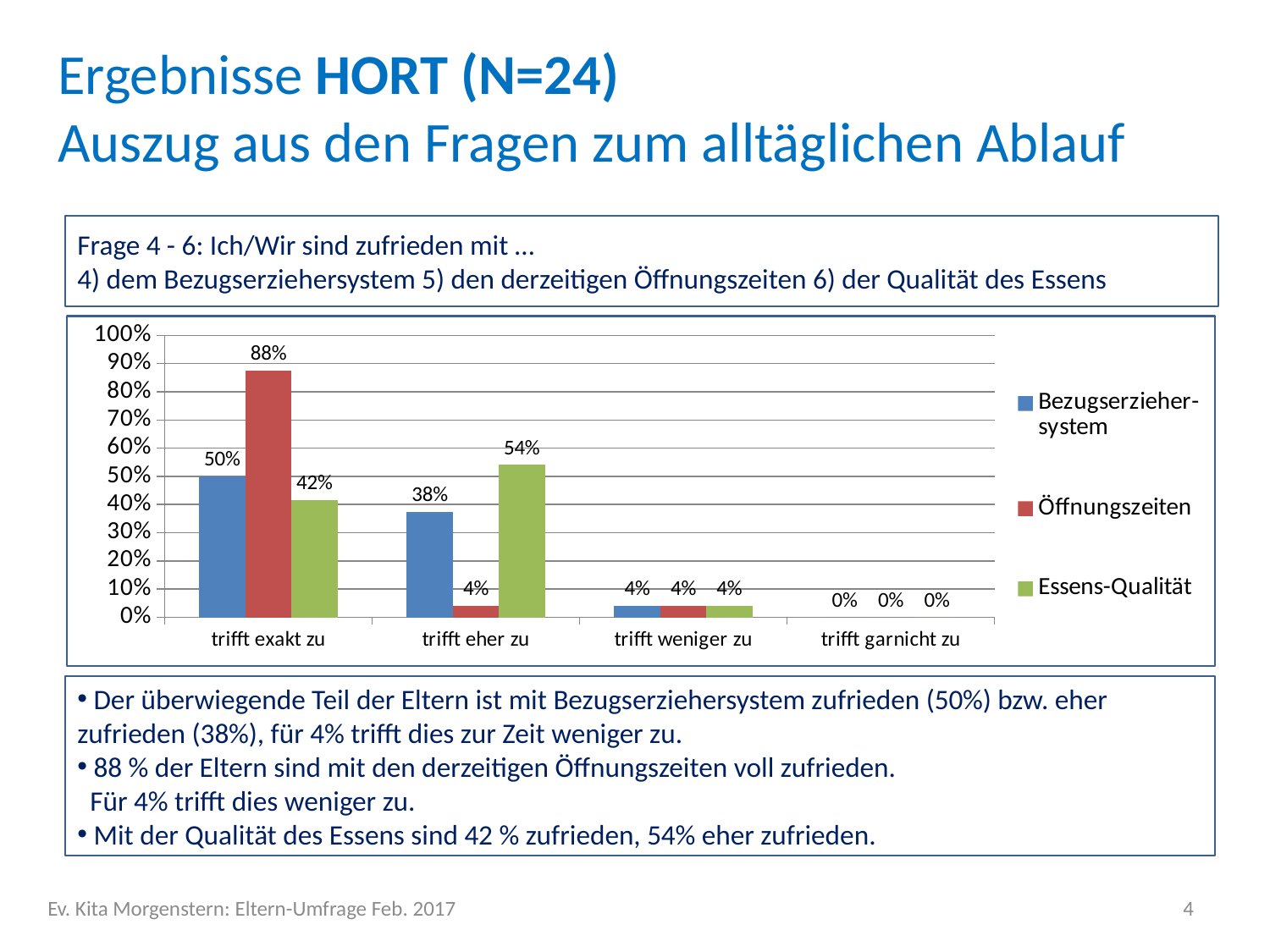
What kind of chart is shown on the slide? bar chart What is the value for Öffnungszeiten in the 'trifft exakt zu' category? 88% Which series has the lowest value in the 'trifft eher zu' category? Öffnungszeiten What value do all three series show in the 'trifft garnicht zu' category? 0% What is the value for Bezugserziehersystem in the 'trifft eher zu' category? 38% Which series has the highest value in the 'trifft exakt zu' category? Öffnungszeiten What is the difference between the Öffnungszeiten and Bezugserziehersystem values in the 'trifft exakt zu' category? 38% What is the value for Essens-Qualität in the 'trifft eher zu' category? 54% Which is larger: Essens-Qualität for 'trifft exakt zu' or Essens-Qualität for 'trifft eher zu'? trifft eher zu How many series does the legend list? 3 Do the values for Öffnungszeiten rise or fall from 'trifft exakt zu' to 'trifft garnicht zu'? fall How many categories are shown on the x axis? 4